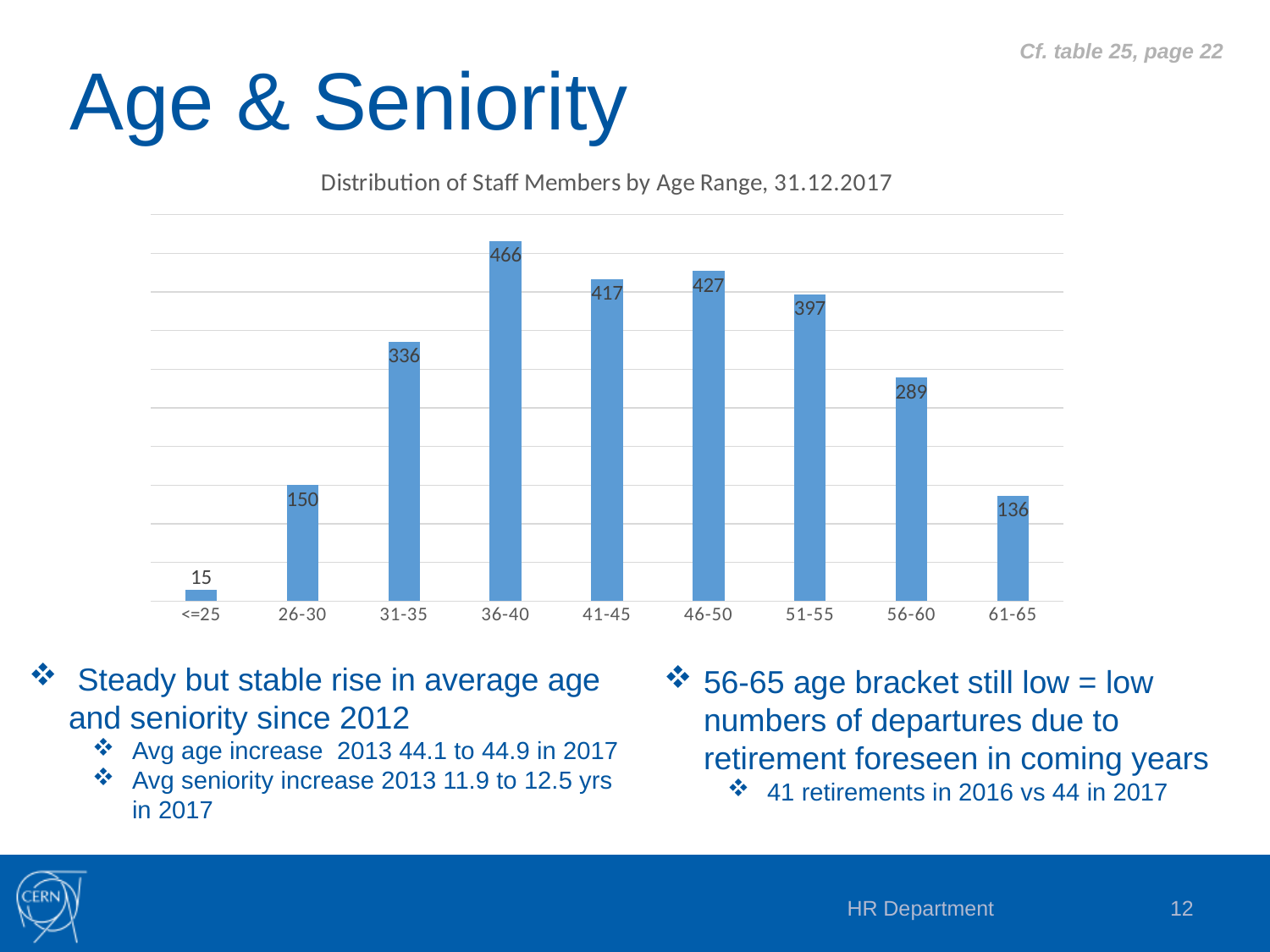
What is the number of staff members in the <=25 age range? 15 What is the number of staff members in the 36-40 age range? 466 Which age range has the lowest number of staff members? <=25 Which age range has more staff members, 26-30 or 61-65? 26-30 What is the difference between the number of staff members in the 46-50 and 41-45 age ranges? 10 What is the title of the chart? Distribution of Staff Members by Age Range, 31.12.2017 What type of chart is used to show the distribution of staff members by age range? Bar chart How many age ranges are shown on the chart? 9 Which age range has more staff members, 31-35 or 51-55? 51-55 Which age range has the highest number of staff members? 36-40 What is the difference between the number of staff members in the 36-40 and 61-65 age ranges? 330 What is the number of staff members in the 56-60 age range? 289